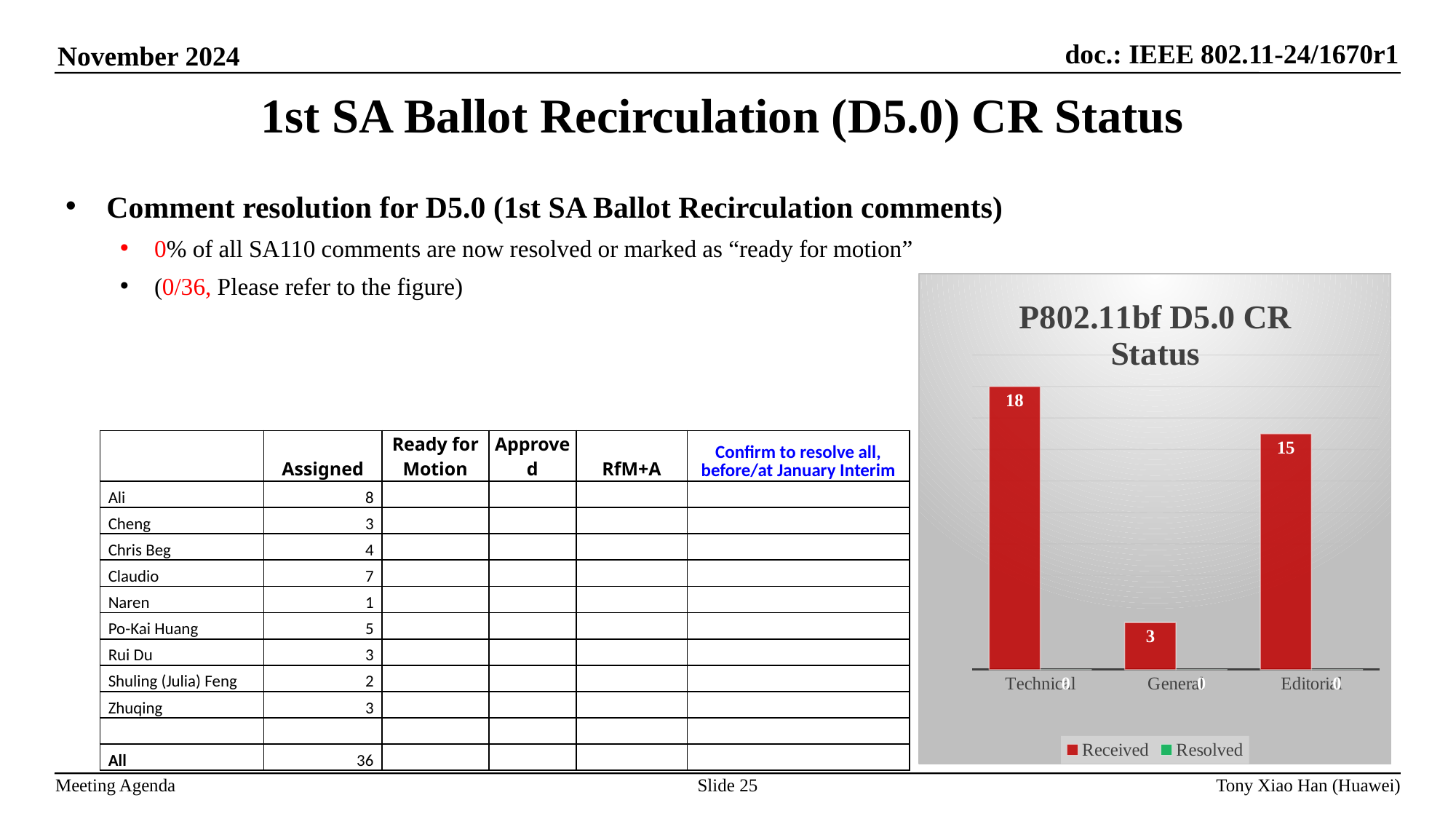
What is the difference between the Received values for Technical and Editorial? 3 Which category has the lowest Received value? General What is the Received value for General? 3 Which has a larger Received value, General or Editorial? Editorial What is the Received value for Editorial? 15 Which series is shown in red in the chart? Received What is the title of the chart on the slide? P802.11bf D5.0 CR Status How many series does the chart legend list? 2 Which category has the highest Received value? Technical How many categories are shown on the x axis of the chart? 3 What type of chart is shown on the slide? bar chart What is the Received value for Technical? 18